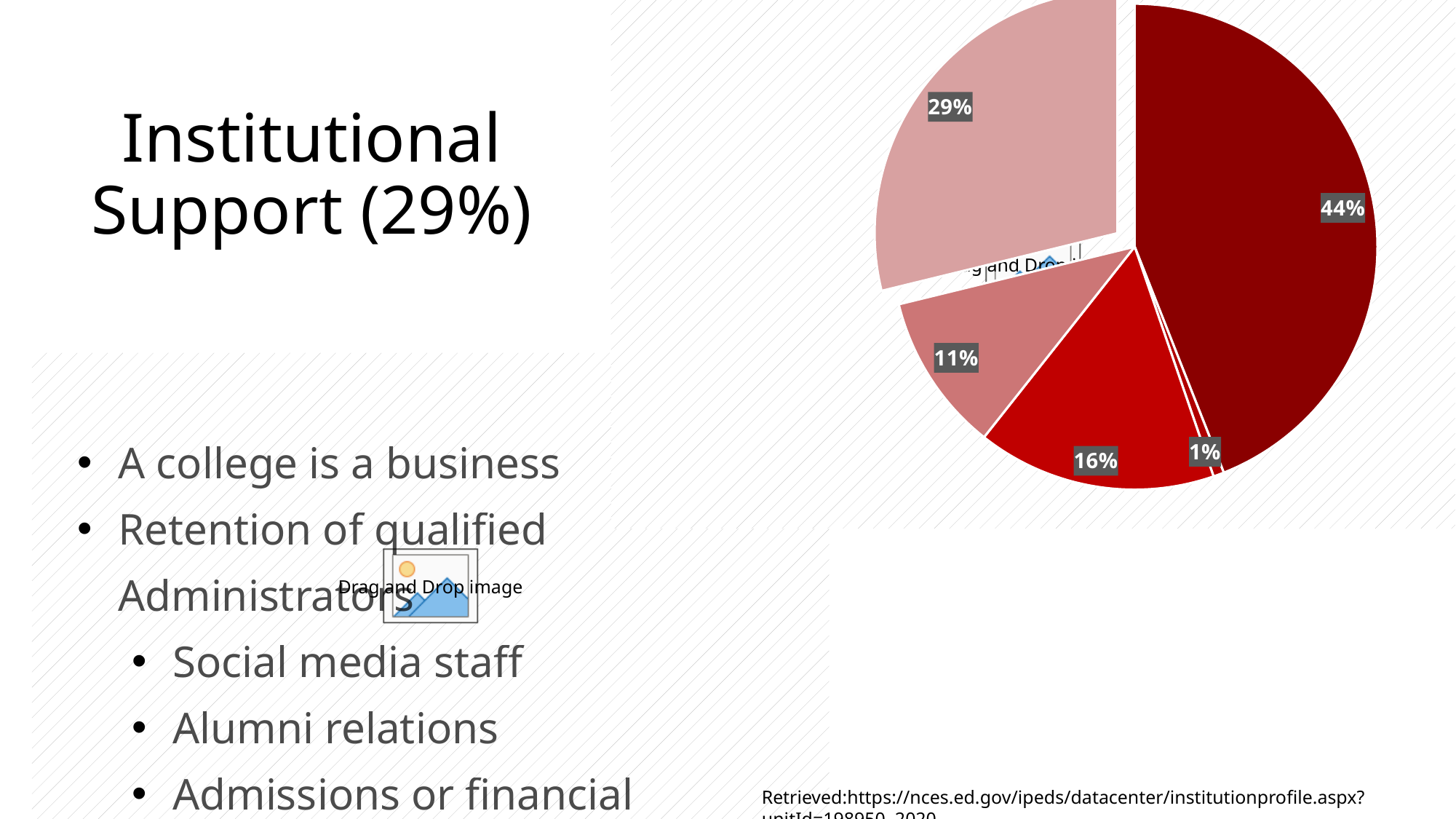
How many slices does the pie chart have? 5 Which is larger: the slice labeled 29% or the slice labeled 16%? 29% What percentage is labeled on the lightest pink slice of the pie chart? 29% What kind of chart is shown on the slide? pie chart What is the largest percentage shown on the pie chart? 44% What is the smallest percentage shown on the pie chart? 1% According to the slide, what share of the pie does Institutional Support represent? 29% What is the difference in percentage points between the largest slice (44%) and the Institutional Support slice (29%)? 15 What percentage is labeled on the darkest red slice of the pie chart? 44% Which is larger: the slice labeled 16% or the slice labeled 11%? 16% What is the difference in percentage points between the 16% slice and the 11% slice? 5 What is the difference in percentage points between the 29% slice and the 1% slice? 28